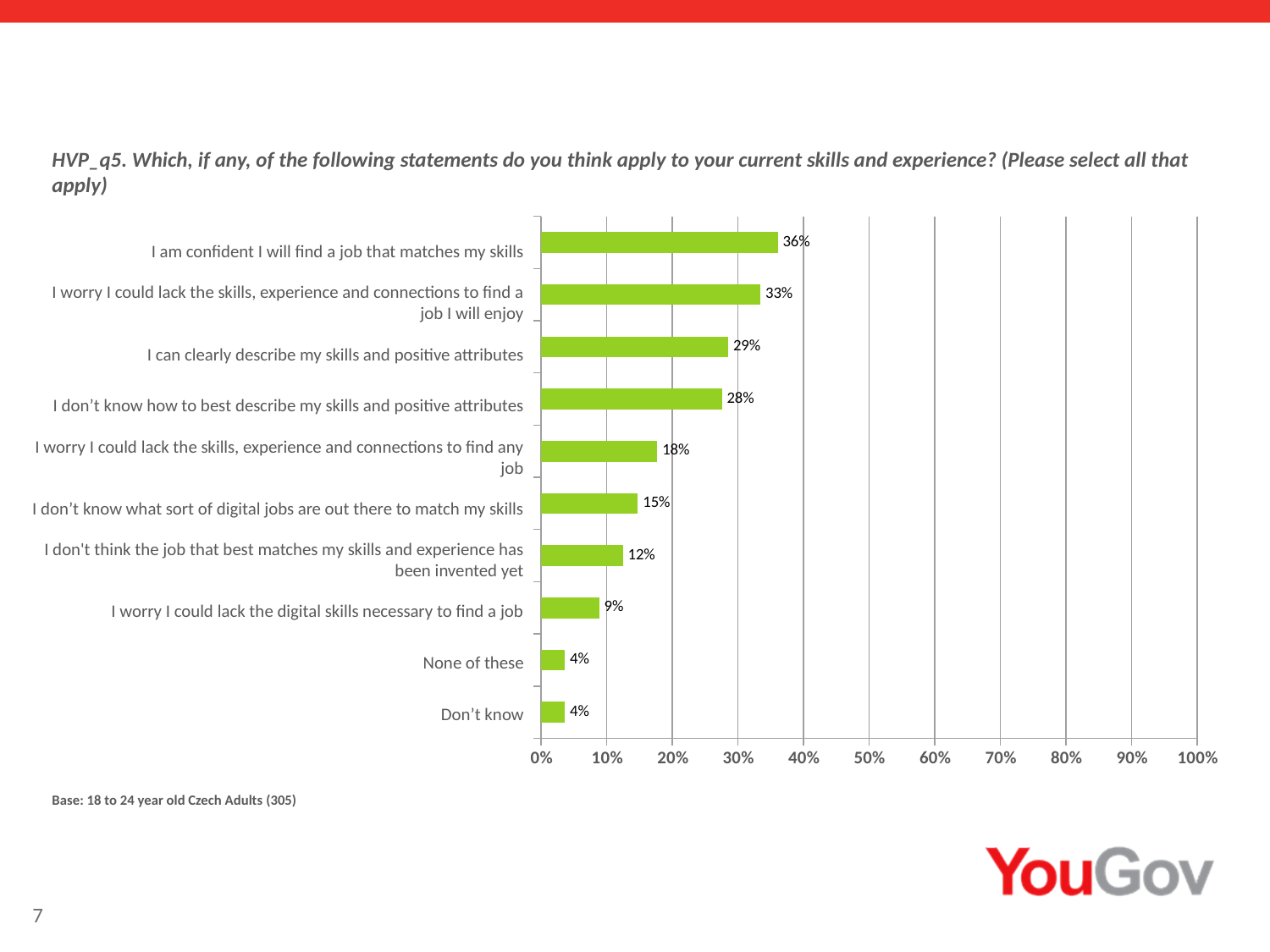
What percentage of respondents said "I am confident I will find a job that matches my skills"? 36% Which is larger: "I can clearly describe my skills and positive attributes" or "I worry I could lack the skills, experience and connections to find any job"? I can clearly describe my skills and positive attributes What type of chart is shown on the slide? bar chart Which statement has the highest percentage? I am confident I will find a job that matches my skills What is the difference between "I am confident I will find a job that matches my skills" and "I worry I could lack the skills, experience and connections to find a job I will enjoy"? 3% Is the value for "I don't know how to best describe my skills and positive attributes" greater or less than 20%? greater What is the difference between "I don't think the job that best matches my skills and experience has been invented yet" and "None of these"? 8% What percentage selected "I don't know what sort of digital jobs are out there to match my skills"? 15% What is the lowest value shown on the chart? 4% What is the value for "I worry I could lack the digital skills necessary to find a job"? 9% How many statements (categories) are shown on the chart? 10 What is the base (sample) described below the chart? 18 to 24 year old Czech Adults (305)